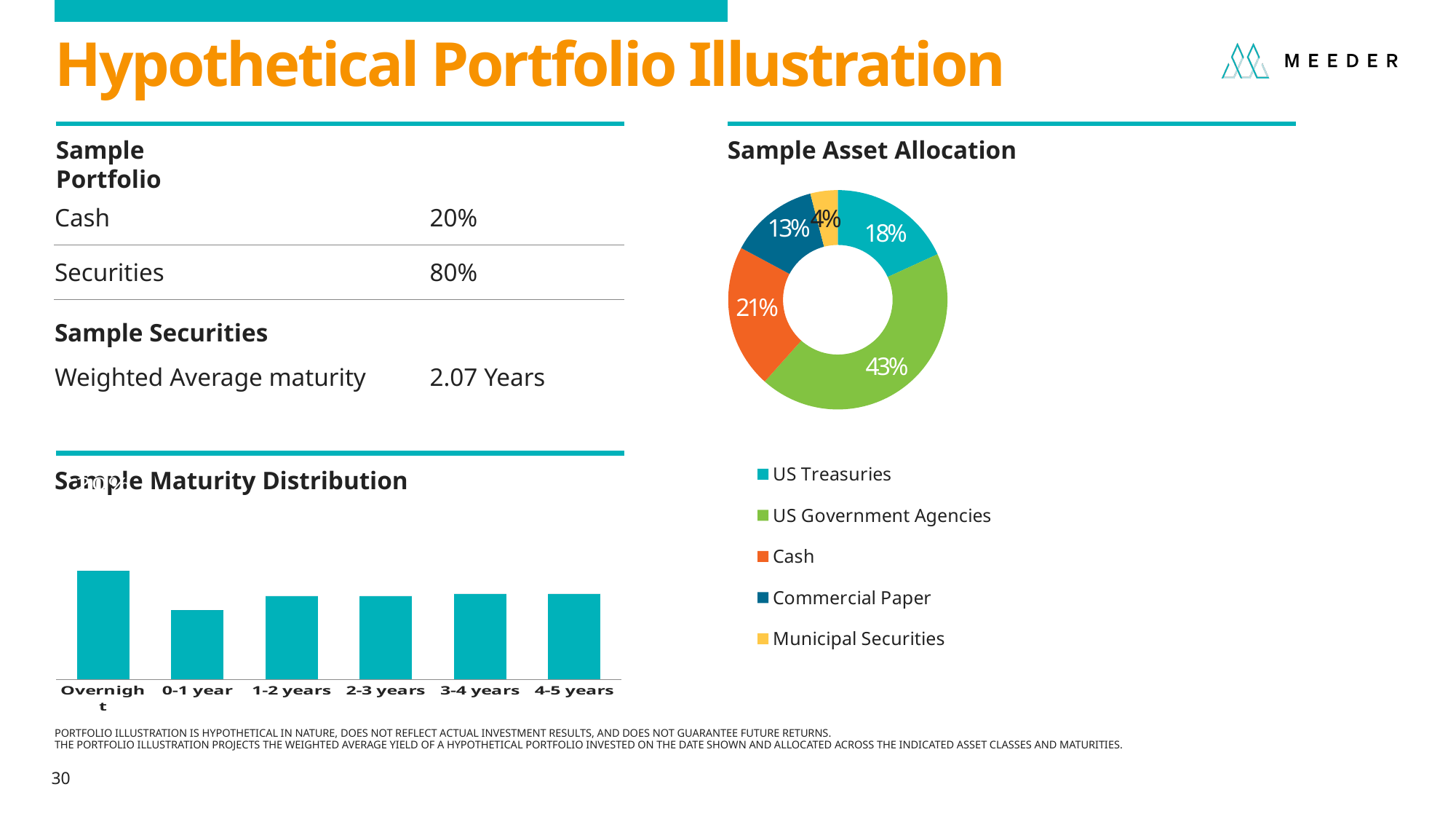
What kind of chart is the Sample Maturity Distribution chart? Bar chart In the Sample Asset Allocation chart, which category has the largest share? US Government Agencies In the Sample Asset Allocation chart, what share is Cash? 21% In the Sample Asset Allocation chart, what share is US Government Agencies? 43% In the Sample Asset Allocation chart, what share is Municipal Securities? 4% How many categories does the legend of the Sample Asset Allocation chart list? 5 In the Sample Asset Allocation chart, which category has the smallest share? Municipal Securities In the Sample Maturity Distribution chart, which maturity bucket has the tallest bar? Overnight In the Sample Asset Allocation chart, what is the difference between the US Government Agencies share and the US Treasuries share? 25% In the Sample Maturity Distribution chart, which maturity bucket has the shortest bar? 0-1 year In the Sample Asset Allocation chart, which is larger, Cash or US Treasuries? Cash In the Sample Asset Allocation chart, what share is Commercial Paper? 13%